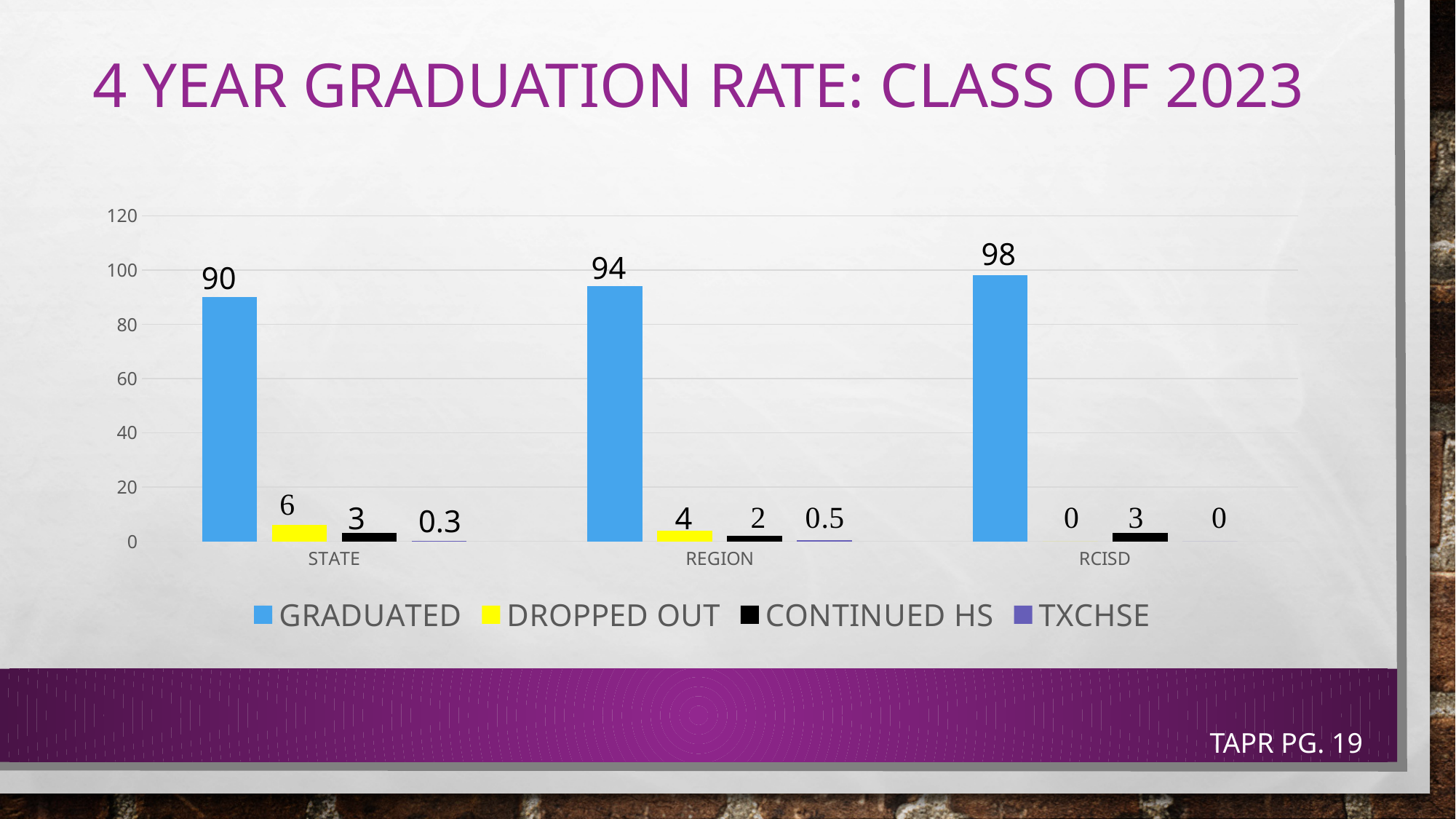
What is the difference between the Graduated values for RCISD and State? 8 Is the Graduated value for Region greater or less than 80? greater What is the Dropped Out value for State? 6 What is the TXCHSE value for Region? 0.5 What is the Graduated value for RCISD? 98 Which category has the lowest Graduated value? State What is the Continued HS value for RCISD? 3 Which category has the highest Graduated value? RCISD How many categories are shown on the x axis? 3 Which is larger, the Dropped Out value for State or for Region? State How many series does the legend list? 4 What kind of chart is shown on the slide? bar chart